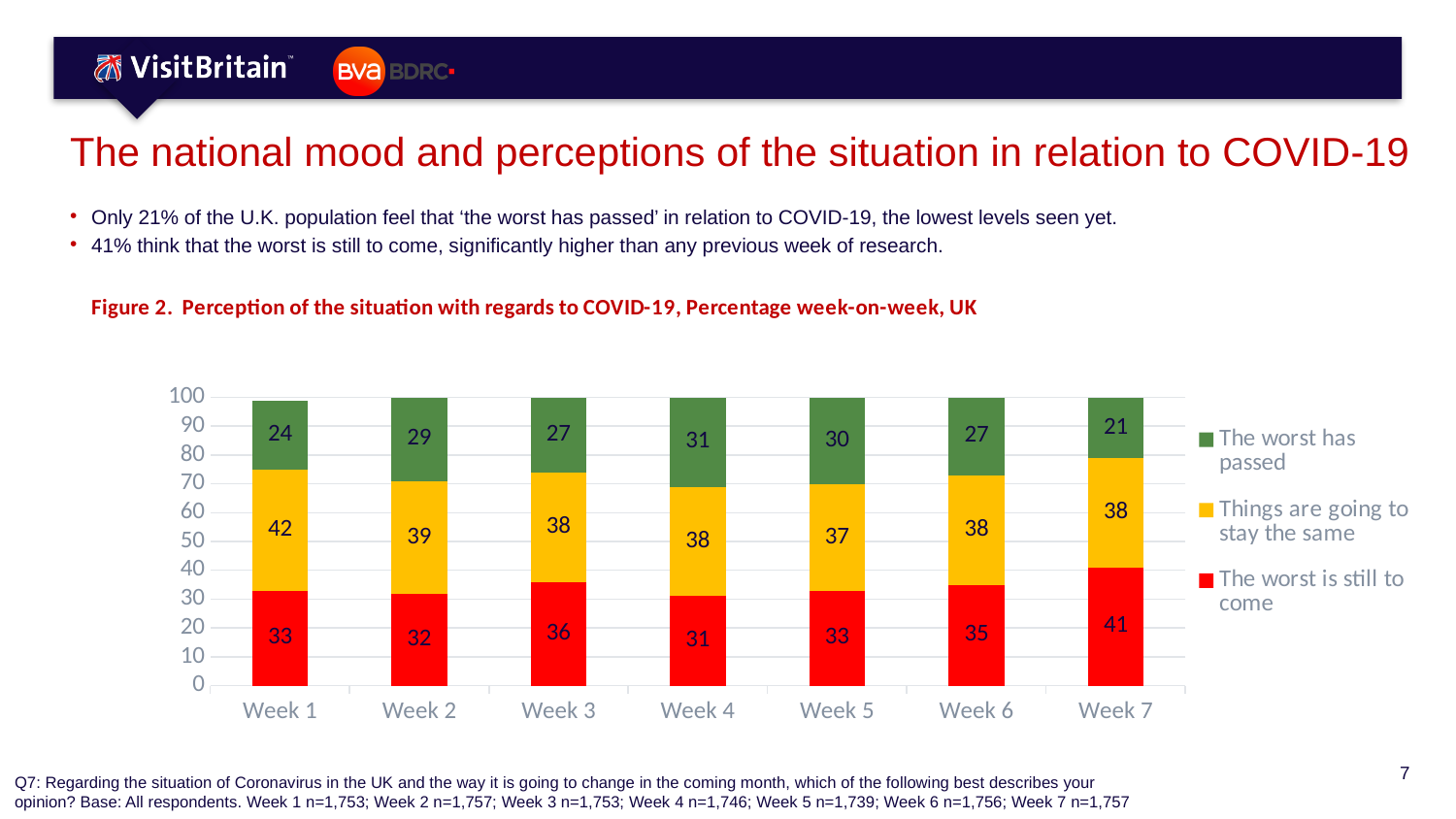
What is the value for 'Things are going to stay the same' in Week 1? 42 Which colour represents 'The worst is still to come'? Red Which is larger in Week 2: 'Things are going to stay the same' or 'The worst has passed'? Things are going to stay the same In which week is 'The worst has passed' lowest? Week 7 What kind of chart is shown? Stacked bar chart What is the difference between 'The worst is still to come' in Week 7 and Week 1? 8 What is the value for 'The worst has passed' in Week 4? 31 In which week is 'The worst is still to come' highest? Week 7 What is the total of the stacked bar for Week 3? 101 How many weeks are shown on the x axis? 7 How many series does the legend list? 3 What is the value for 'The worst is still to come' in Week 7? 41